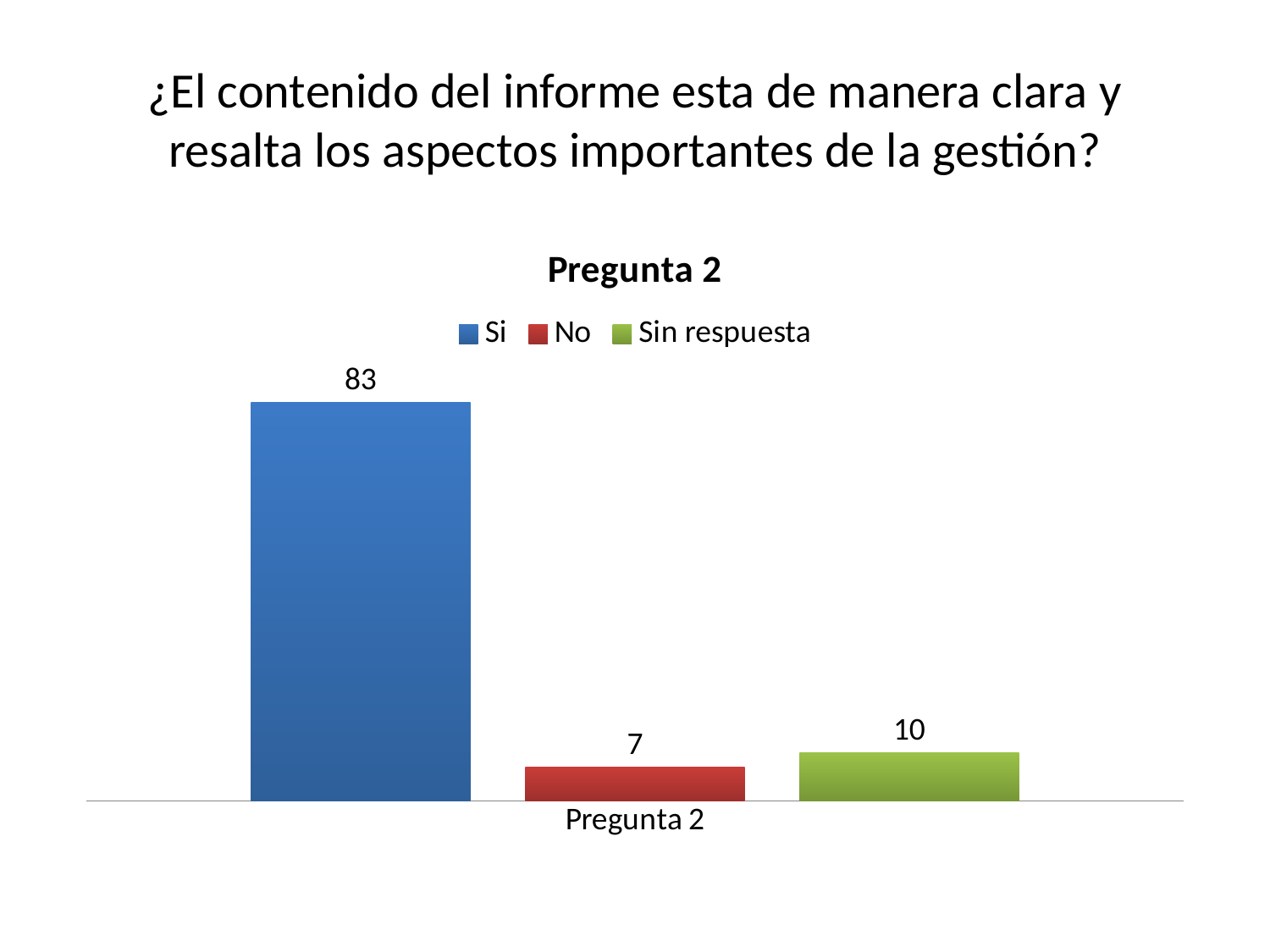
Which series has the lowest value? No How many series does the legend list? 3 What is the value for Si? 83 What is the value for No? 7 What is the difference between the values for Si and No? 76 What kind of chart is shown? bar chart What is the title of the chart? Pregunta 2 What is the difference between the values for Sin respuesta and No? 3 What colour is the bar for Sin respuesta? green Which is larger, the value for No or the value for Sin respuesta? Sin respuesta Which series has the highest value? Si What is the value for Sin respuesta? 10